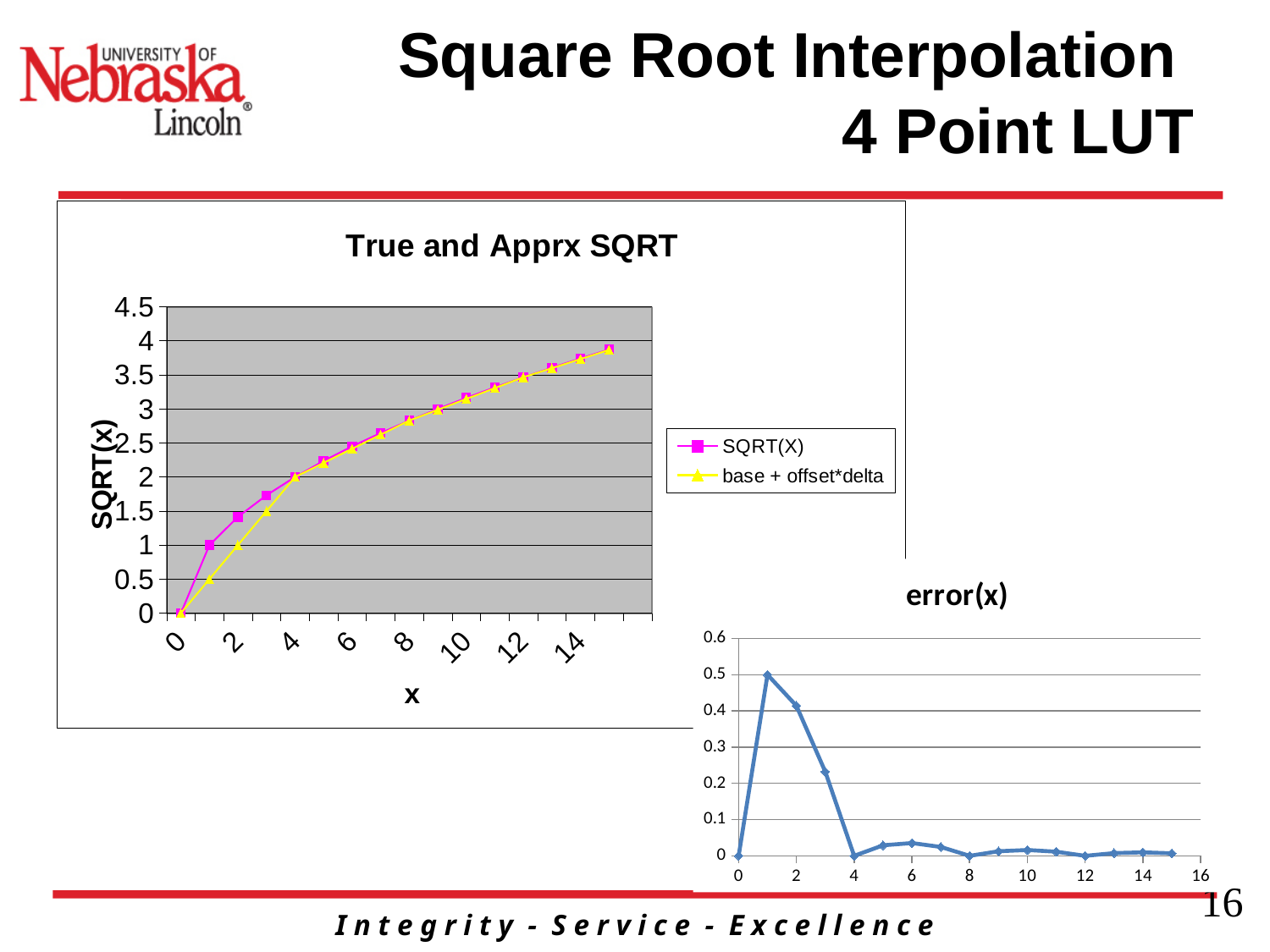
What are the two series named in the legend of the "True and Apprx SQRT" chart? SQRT(X) and base + offset*delta In the "True and Apprx SQRT" chart, is the base + offset*delta value at x = 2 greater or less than 1.5? less In the "True and Apprx SQRT" chart, what is the y-axis title? SQRT(x) What kind of chart is the "True and Apprx SQRT" chart? line chart In the "error(x)" chart, is the error at x = 2 greater or less than 0.3? greater How many series does the legend of the "True and Apprx SQRT" chart list? 2 In the "True and Apprx SQRT" chart, do the SQRT(X) values rise or fall as x increases? rise In the "error(x)" chart, is the error at x = 3 greater or less than 0.3? less In the "error(x)" chart, at which x value is the error highest? 1 In the "error(x)" chart, is the error at x = 2 larger or smaller than the error at x = 3? larger In the "True and Apprx SQRT" chart, is the SQRT(X) value at x = 1 greater or less than the base + offset*delta value at x = 1? greater